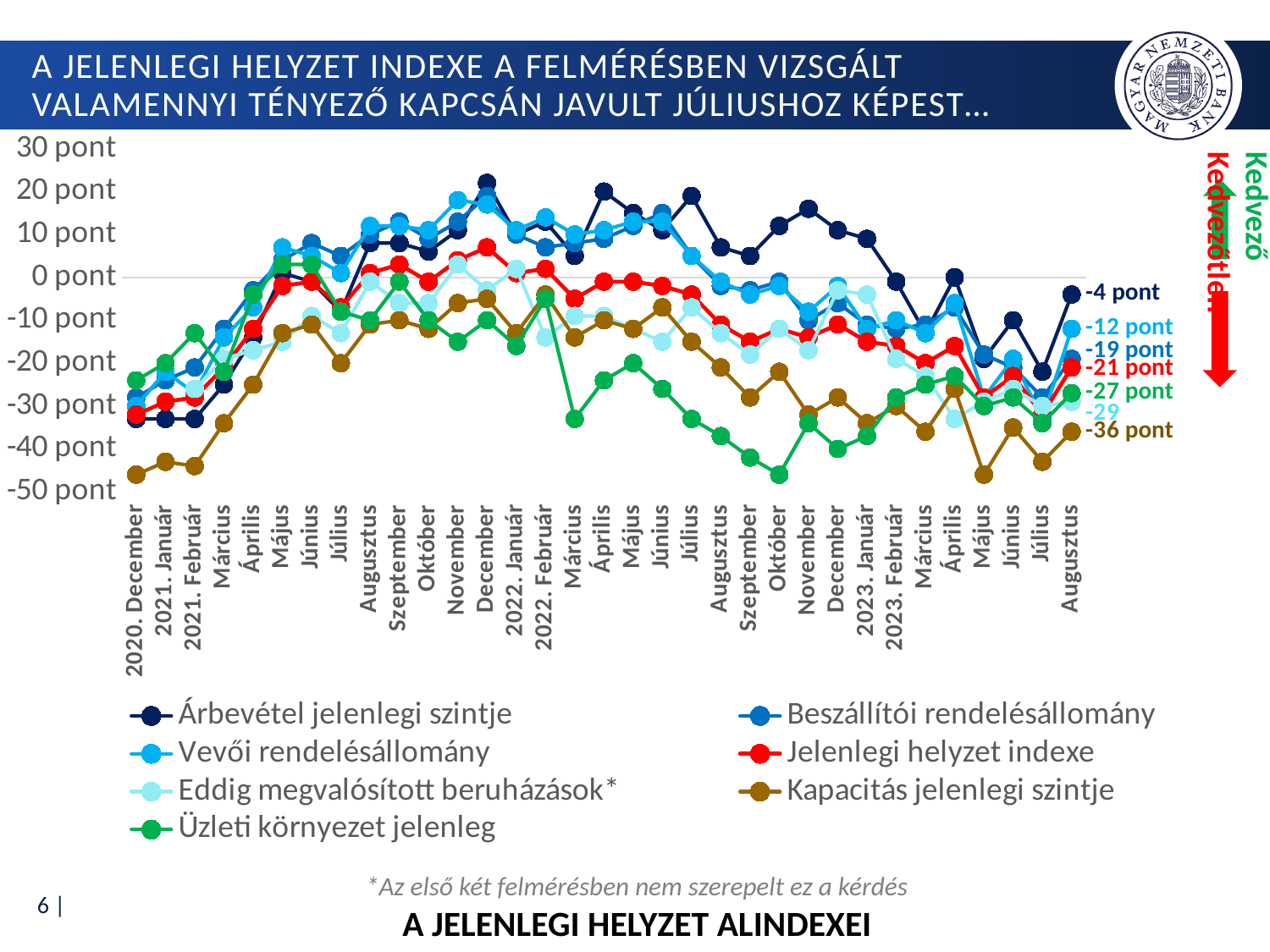
What kind of chart is shown on the slide? line chart What is the value of Árbevétel jelenlegi szintje in 2023 Augusztus? -4 pont Which series has the highest value in 2023 Augusztus? Árbevétel jelenlegi szintje In 2023 Augusztus, which is larger: Jelenlegi helyzet indexe or Üzleti környezet jelenleg? Jelenlegi helyzet indexe Is the value for Kapacitás jelenlegi szintje in 2020 December greater or less than -40 pont? less What is the difference between Árbevétel jelenlegi szintje and Kapacitás jelenlegi szintje in 2023 Augusztus? 32 pont Which series has the lowest value in 2023 Augusztus? Kapacitás jelenlegi szintje What is the value of Jelenlegi helyzet indexe in 2023 Augusztus? -21 pont What is the title shown below the chart? A JELENLEGI HELYZET ALINDEXEI What is the value of Üzleti környezet jelenleg in 2023 Augusztus? -27 pont How many series does the legend list? 7 What is the value of Kapacitás jelenlegi szintje in 2023 Augusztus? -36 pont